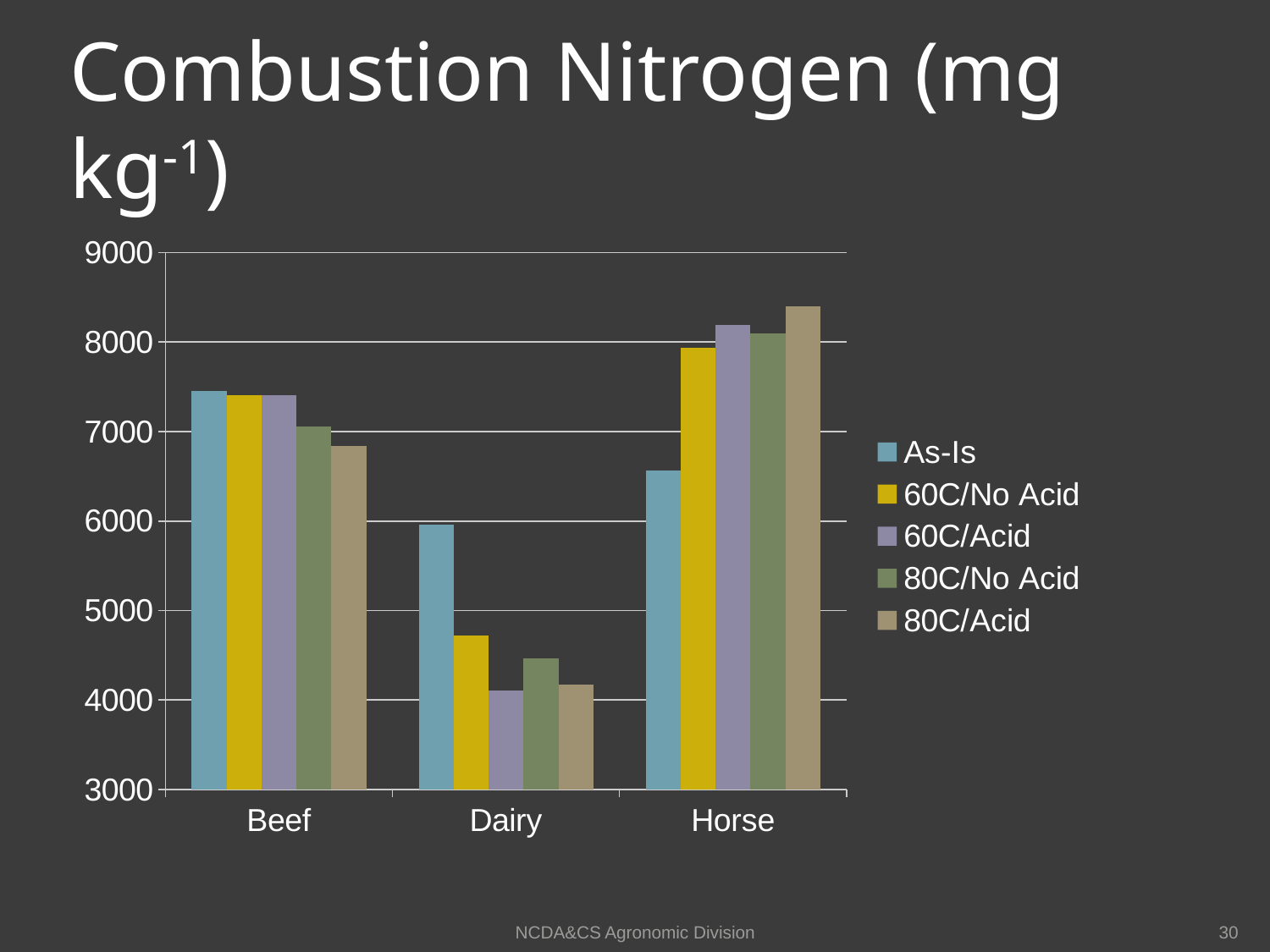
Is the 80C/Acid value for Beef greater or less than 7000? less Which category has the highest 80C/Acid value? Horse How many categories are shown on the x axis? 3 What kind of chart is shown on the slide? bar chart For Dairy, which is larger: the As-Is value or the 60C/No Acid value? As-Is Is the 80C/Acid value for Horse greater or less than 8000? greater Is the As-Is value for Dairy greater or less than 5000? greater Which category has the lowest As-Is value? Dairy Which is larger: the As-Is value for Beef or the As-Is value for Horse? Beef How many series does the legend list? 5 For Horse, which series has the highest value? 80C/Acid